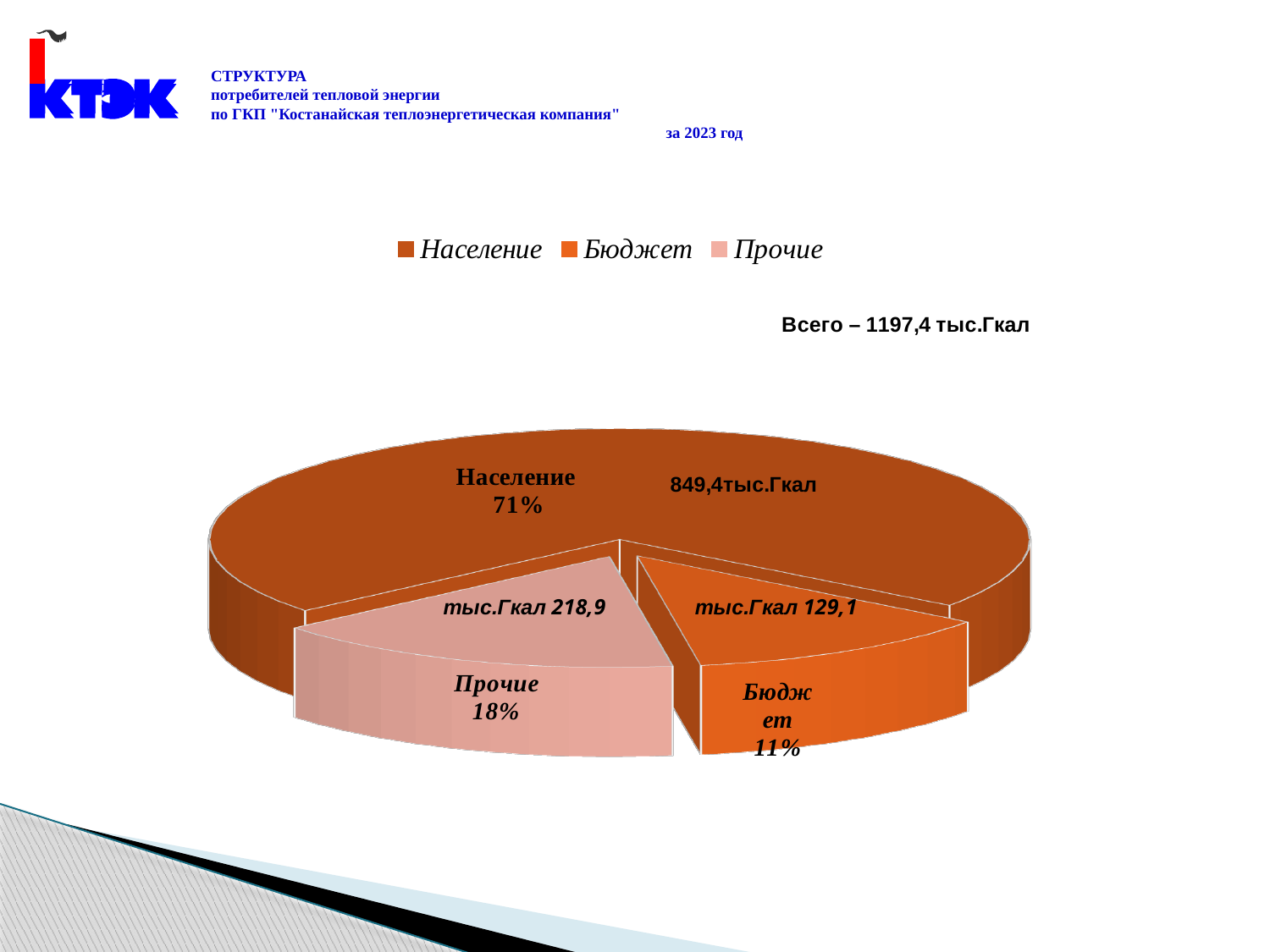
Which category has the smallest slice of the pie? Бюджет What share of the pie does Прочие have? 18% What share of the pie does Население have? 71% How many entries does the legend list? 3 Which category has the largest slice of the pie? Население What share of the pie does Бюджет have? 11% What is the value for Население in тыс.Гкал? 849,4 What kind of chart is shown on the slide? pie chart What total is stated on the slide for all consumers? 1197,4 тыс.Гкал What is the value for Бюджет in тыс.Гкал? 129,1 How many slices does the pie chart have? 3 What is the value for Прочие in тыс.Гкал? 218,9